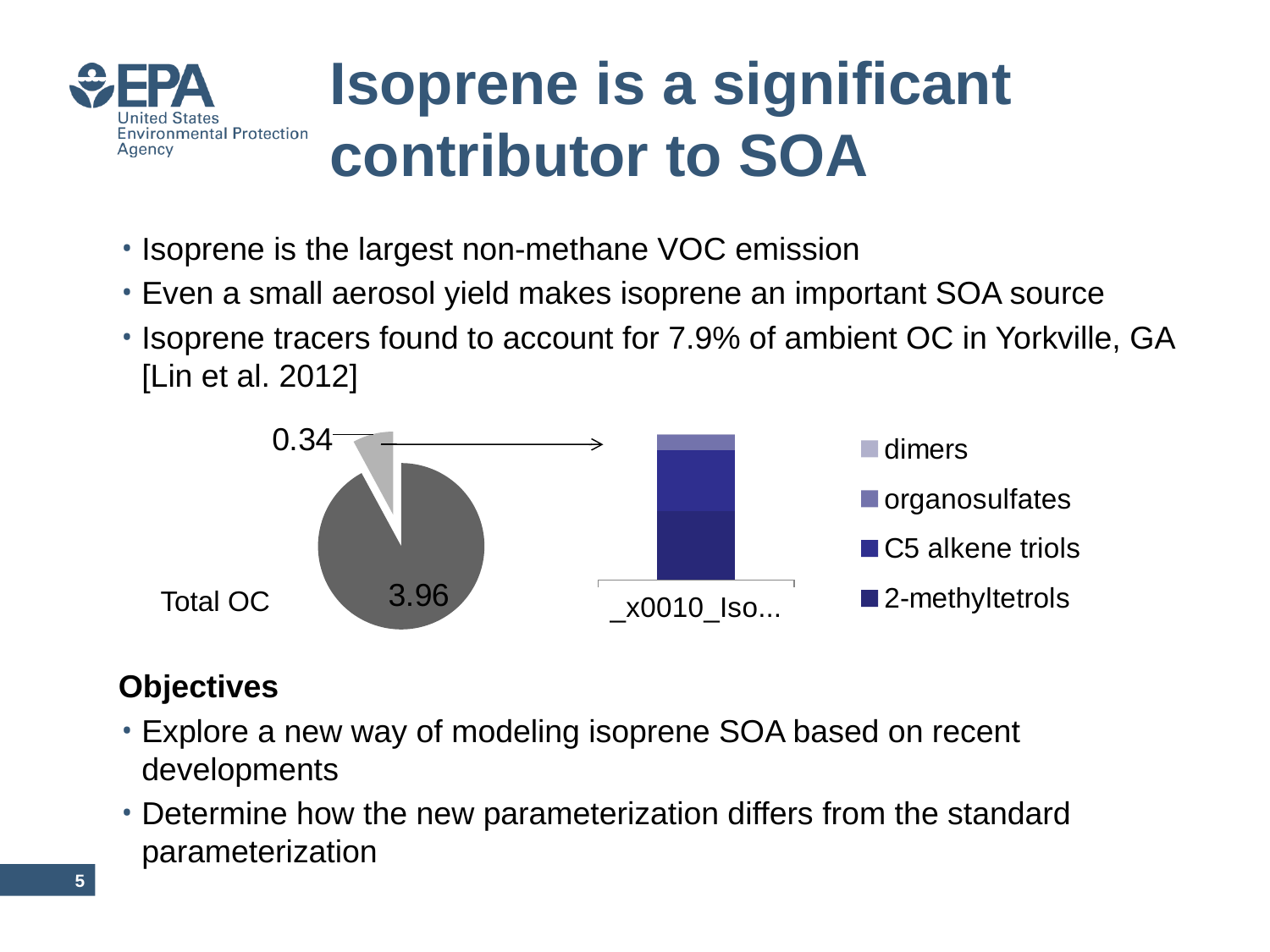
In the Total OC pie chart, what is the difference between the two slice values, 3.96 and 0.34? 3.62 In the Total OC pie chart, what is the total of the two slice values? 4.30 In the Total OC pie chart, what is the value of the large dark grey slice? 3.96 What kind of chart is the one labelled "Total OC" on the left? pie chart In the Total OC pie chart, what is the value of the small exploded light grey slice? 0.34 In the Total OC pie chart, how many slices are there? 2 In the Total OC pie chart, which slice value is larger, 3.96 or 0.34? 3.96 What kind of chart is the one on the right with the legend listing dimers, organosulfates, C5 alkene triols and 2-methyltetrols? bar chart In the stacked bar chart on the right, which series forms the largest segment of the bar? 2-methyltetrols In the Total OC pie chart, what share of the whole pie is the 0.34 slice? 7.9% In the stacked bar chart on the right, how many series does the legend list? 4